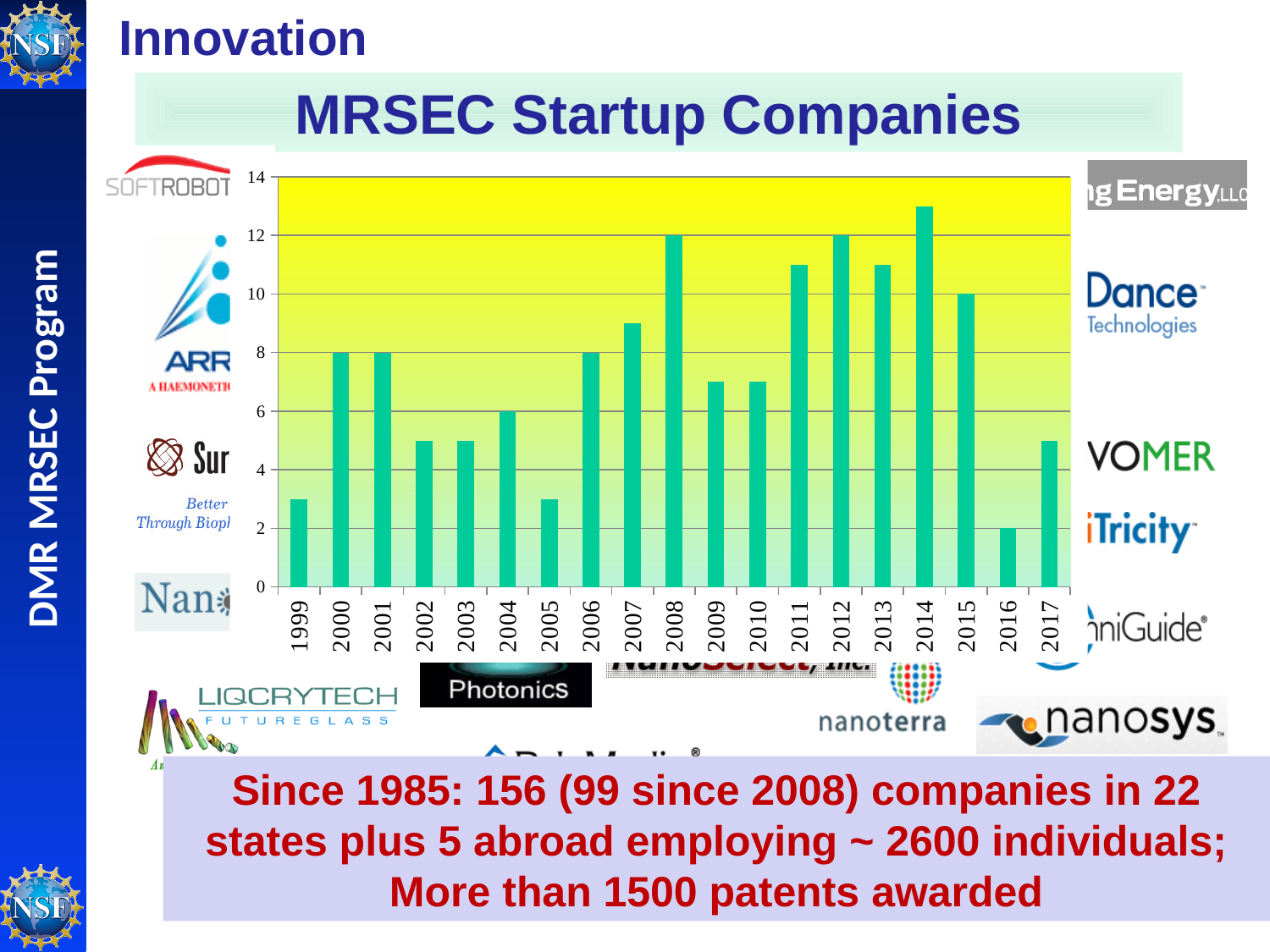
Which year has the highest bar in the MRSEC Startup Companies chart? 2014 What is the value for 2008 in the MRSEC Startup Companies chart? 12 What kind of chart is shown on the MRSEC Startup Companies slide? bar chart What is the difference between the values for 2008 and 2016 in the MRSEC Startup Companies chart? 10 Which year has the larger value in the MRSEC Startup Companies chart, 2008 or 2009? 2008 Is the value for 1999 greater or less than 4 in the MRSEC Startup Companies chart? less What is the value for 2015 in the MRSEC Startup Companies chart? 10 Is the value for 2014 greater or less than 12 in the MRSEC Startup Companies chart? greater Which year has the lowest bar in the MRSEC Startup Companies chart? 2016 What is the value for 2016 in the MRSEC Startup Companies chart? 2 How many years are shown on the x axis of the MRSEC Startup Companies chart? 19 What is the value for 2004 in the MRSEC Startup Companies chart? 6